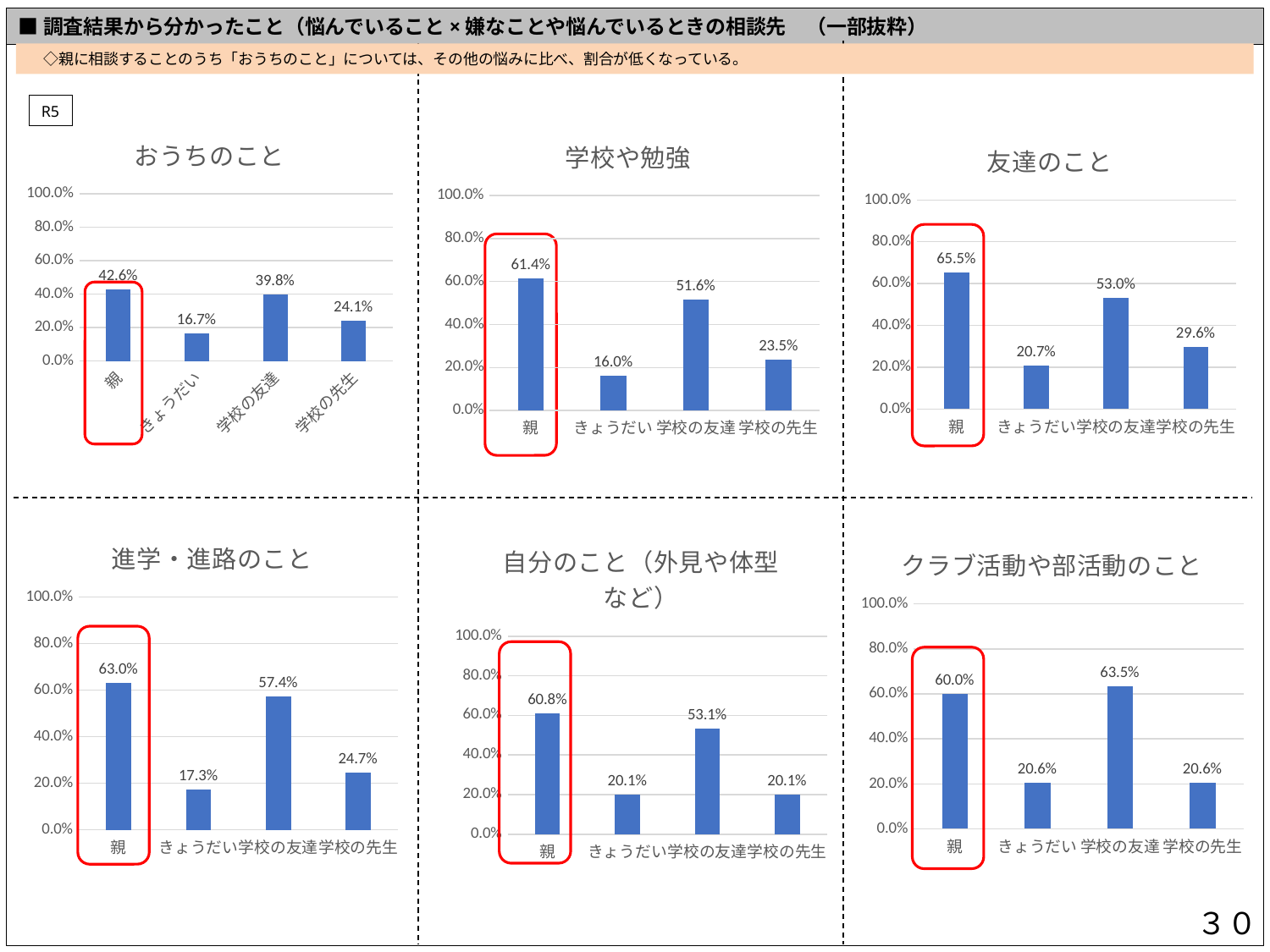
In the 「クラブ活動や部活動のこと」 chart, which category has the highest value? 学校の友達 In the 「進学・進路のこと」 chart, which category has the lowest value? きょうだい How many charts are shown on the slide? 6 In the 「学校や勉強」 chart, what is the difference between 親 and きょうだい? 45.4% In the 「友達のこと」 chart, which category has the highest value? 親 How many categories are shown in the 「友達のこと」 chart? 4 In the 「自分のこと（外見や体型など）」 chart, what is the difference between 親 and 学校の友達? 7.7% In the 「おうちのこと」 chart, which is larger, 親 or 学校の友達? 親 What kind of chart is the 「進学・進路のこと」 chart? Bar chart In the 「学校や勉強」 chart, what is the value for 学校の友達? 51.6% In the 「おうちのこと」 chart, what is the value for 親? 42.6% In the 「クラブ活動や部活動のこと」 chart, what is the value for 学校の先生? 20.6%